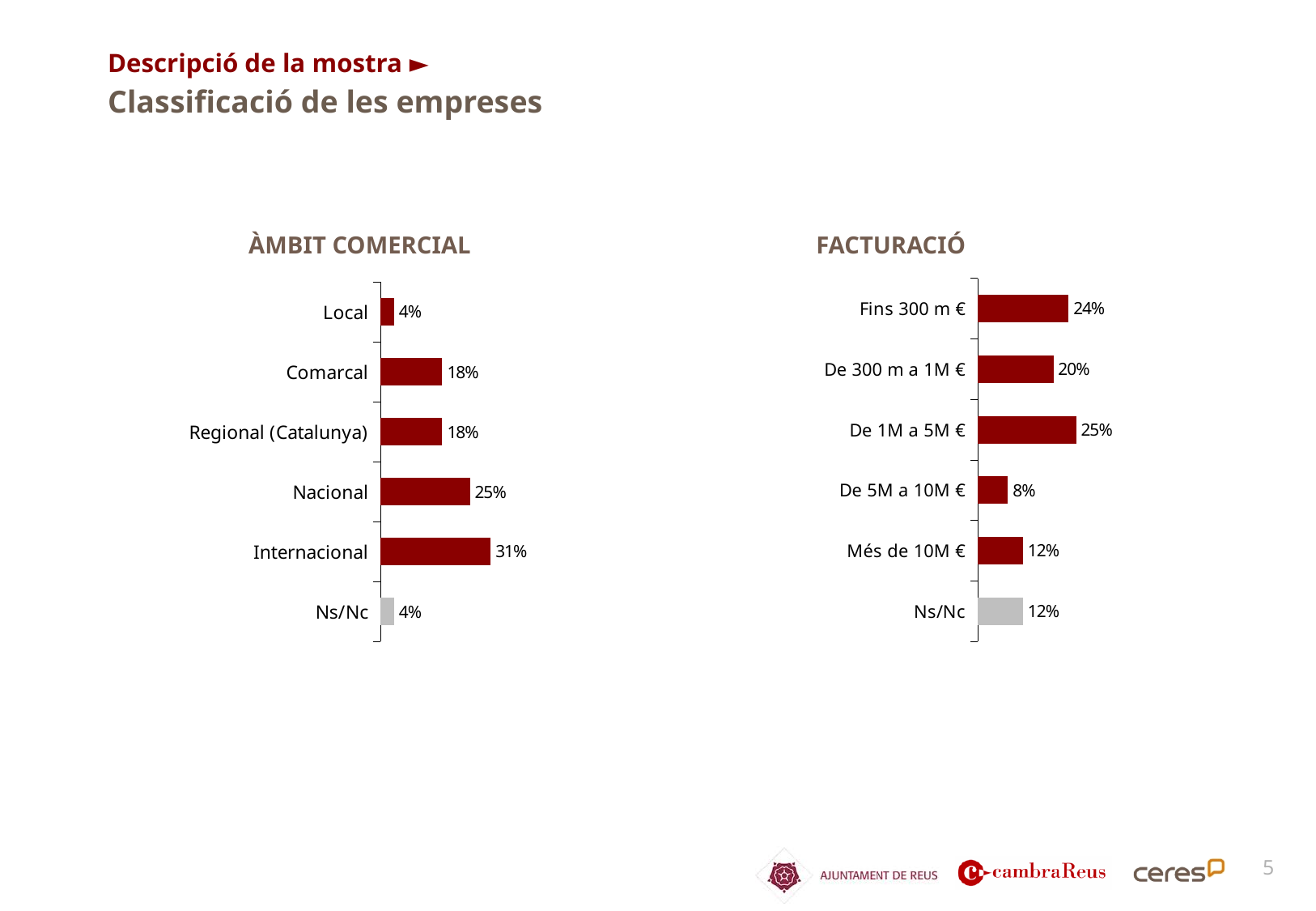
In the FACTURACIÓ chart, which category has the lowest value? De 5M a 10M € In the ÀMBIT COMERCIAL chart, what is the value for Internacional? 31% What kind of chart is the FACTURACIÓ chart? Bar chart In the ÀMBIT COMERCIAL chart, what is the value for Comarcal? 18% In the ÀMBIT COMERCIAL chart, what is the difference between Internacional and Nacional? 6% In the ÀMBIT COMERCIAL chart, which category has the highest value? Internacional In the ÀMBIT COMERCIAL chart, how many categories are shown? 6 In the FACTURACIÓ chart, what is the value for De 1M a 5M €? 25% In the FACTURACIÓ chart, which is larger, Fins 300 m € or De 300 m a 1M €? Fins 300 m € In the FACTURACIÓ chart, what is the difference between Fins 300 m € and Més de 10M €? 12% In the ÀMBIT COMERCIAL chart, which category is shown with a grey bar instead of a dark red one? Ns/Nc In the FACTURACIÓ chart, what is the value for De 5M a 10M €? 8%